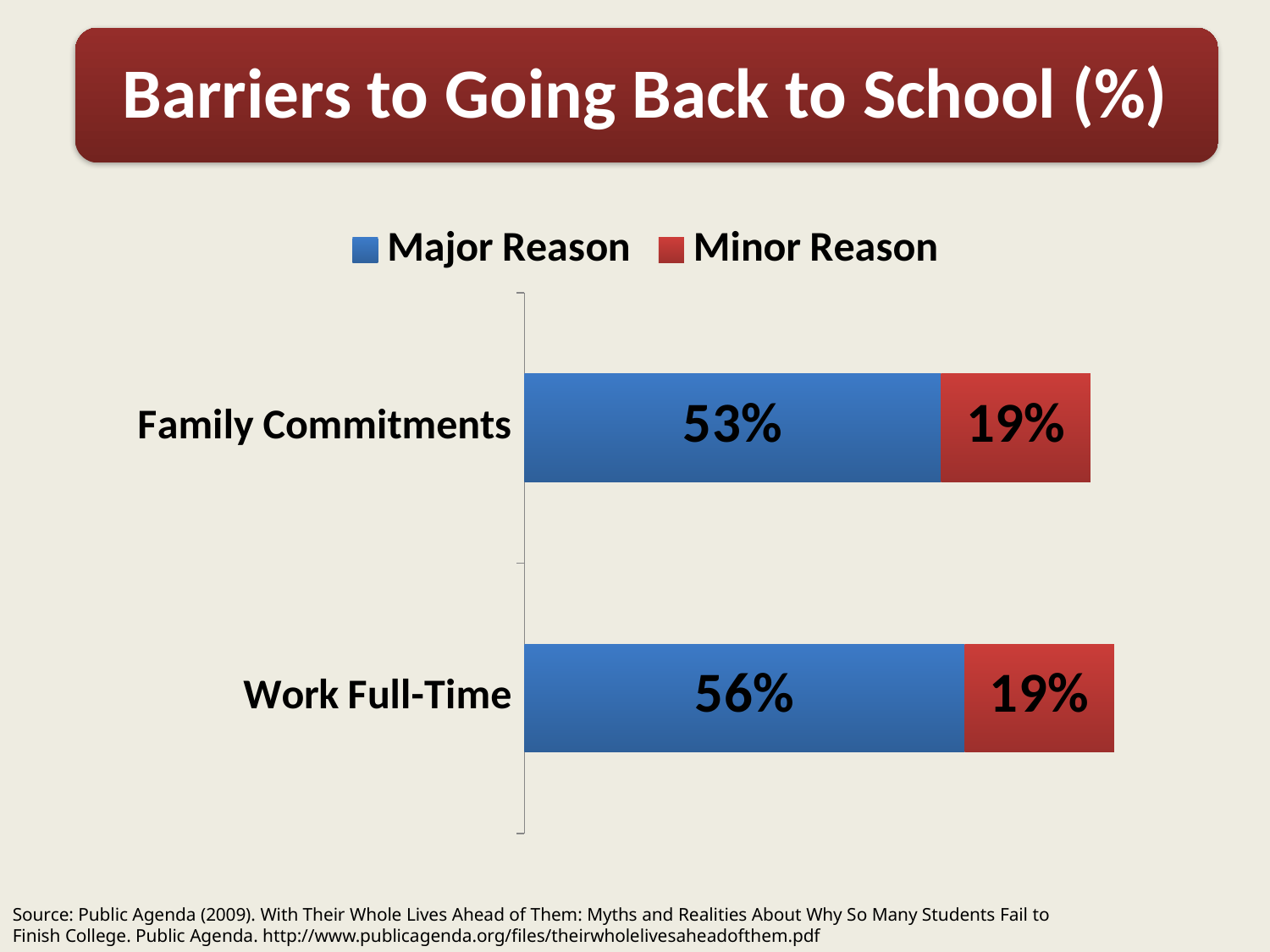
How many barriers (categories) are shown in the chart? 2 Which barrier has the higher Major Reason percentage? Work Full-Time What percentage cite Family Commitments as a Major Reason? 53% What percentage cite Work Full-Time as a Minor Reason? 19% What percentage cite Work Full-Time as a Major Reason? 56% What percentage cite Family Commitments as a Minor Reason? 19% What is the combined Major and Minor Reason total for Family Commitments? 72% Is the Major Reason value for Work Full-Time larger or smaller than the Major Reason value for Family Commitments? larger How many series does the legend list? 2 What is the combined Major and Minor Reason total for Work Full-Time? 75% Which barrier has the lower Major Reason percentage? Family Commitments What is the difference between the Major Reason percentages for Work Full-Time and Family Commitments? 3%